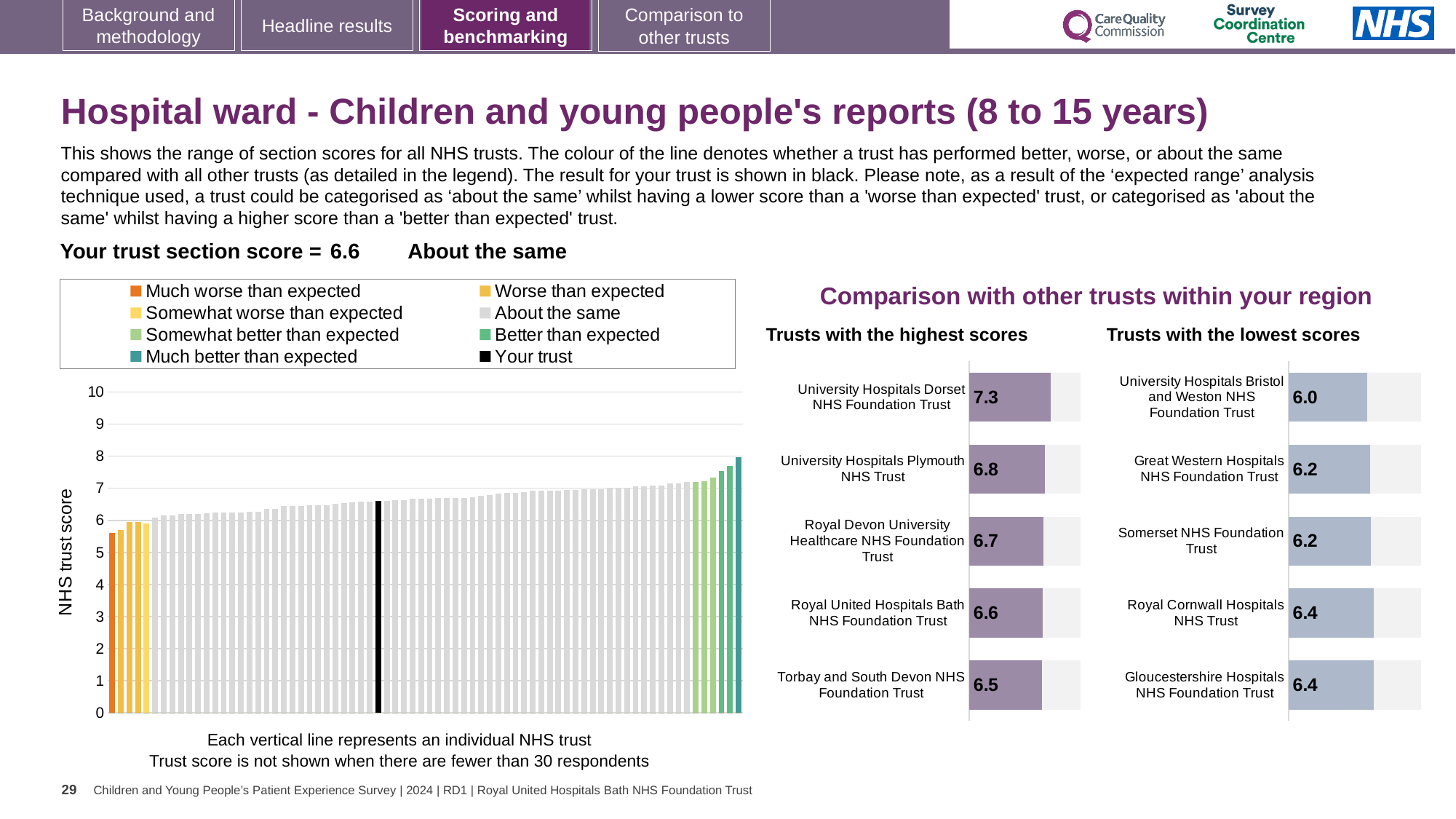
What kind of chart is the NHS trust score chart on the left? Bar chart In the 'Trusts with the lowest scores' chart, what is the score for Great Western Hospitals NHS Foundation Trust? 6.2 In the 'Trusts with the highest scores' chart, which trust has the lowest score shown? Torbay and South Devon NHS Foundation Trust In the NHS trust score chart on the left, is the value of the leftmost (orange) bar greater or less than 6? less In the NHS trust score chart on the left, how many entries does the legend list? 8 In the 'Trusts with the highest scores' chart, what is the score for University Hospitals Dorset NHS Foundation Trust? 7.3 In the 'Trusts with the lowest scores' chart, which trust has the lowest score? University Hospitals Bristol and Weston NHS Foundation Trust In the 'Trusts with the highest scores' chart, what is the difference between the scores of University Hospitals Dorset NHS Foundation Trust and Torbay and South Devon NHS Foundation Trust? 0.8 In the 'Trusts with the highest scores' chart, how many trusts are listed? 5 In the NHS trust score chart on the left, do the trust scores rise or fall from left to right along the x axis? Rise In the 'Trusts with the lowest scores' chart, what is the difference between the scores of Royal Cornwall Hospitals NHS Trust and University Hospitals Bristol and Weston NHS Foundation Trust? 0.4 In the 'Trusts with the highest scores' chart, which has the higher score: University Hospitals Plymouth NHS Trust or Royal United Hospitals Bath NHS Foundation Trust? University Hospitals Plymouth NHS Trust